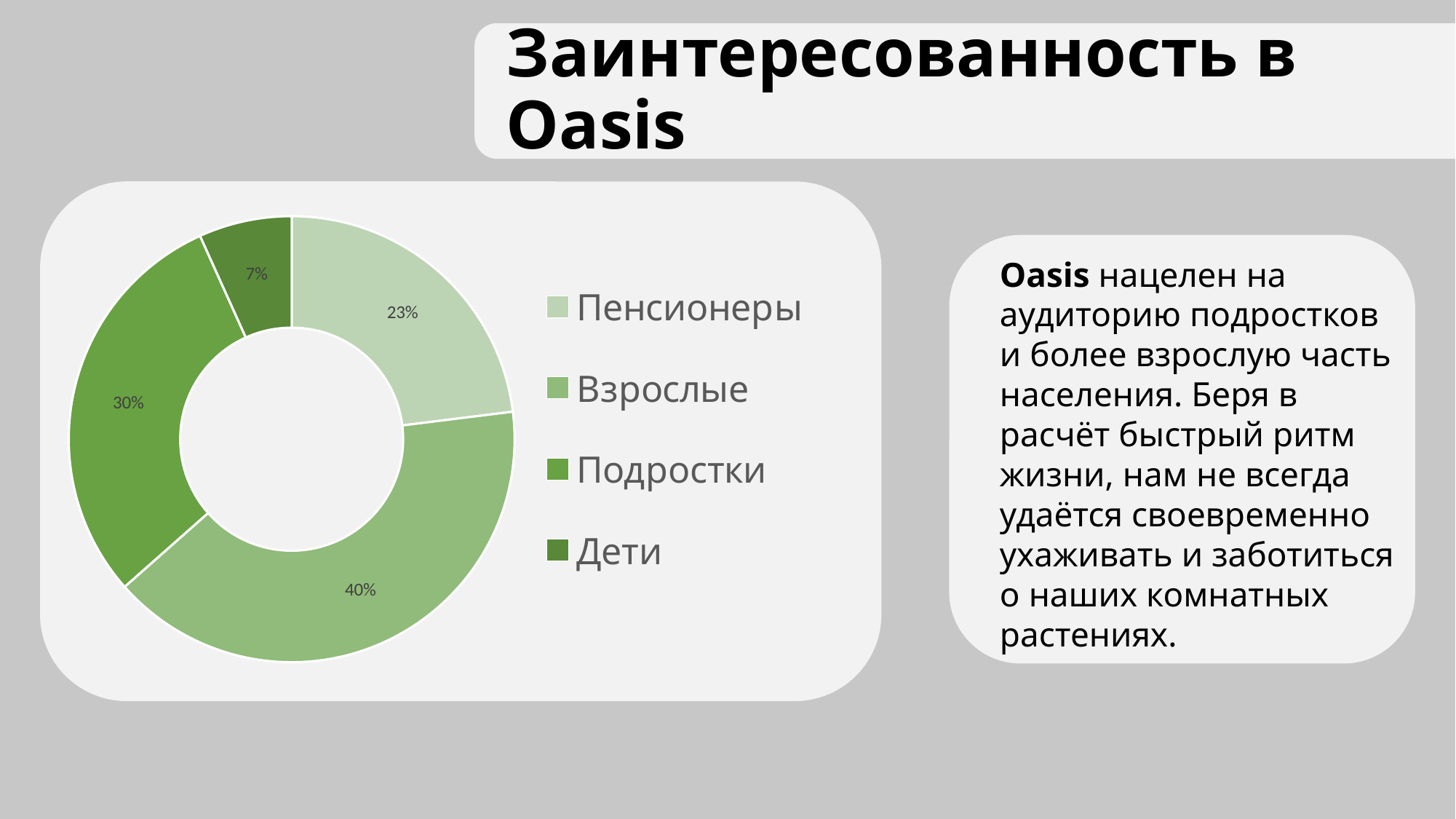
Which category has the largest share in the doughnut chart? Взрослые What is the difference in percentage points between the Взрослые and Подростки shares? 10 What share of the doughnut chart is labelled Подростки? 30% How many categories does the doughnut chart show? 4 Which legend entry is shown with the darkest green colour? Дети What share of the doughnut chart is labelled Взрослые? 40% What kind of chart is shown on the slide? Doughnut chart Which category has the smallest share in the doughnut chart? Дети What share of the doughnut chart is labelled Дети? 7% What is the difference in percentage points between the Пенсионеры and Дети shares? 16 What share of the doughnut chart is labelled Пенсионеры? 23% Which share is larger, Пенсионеры or Подростки? Подростки